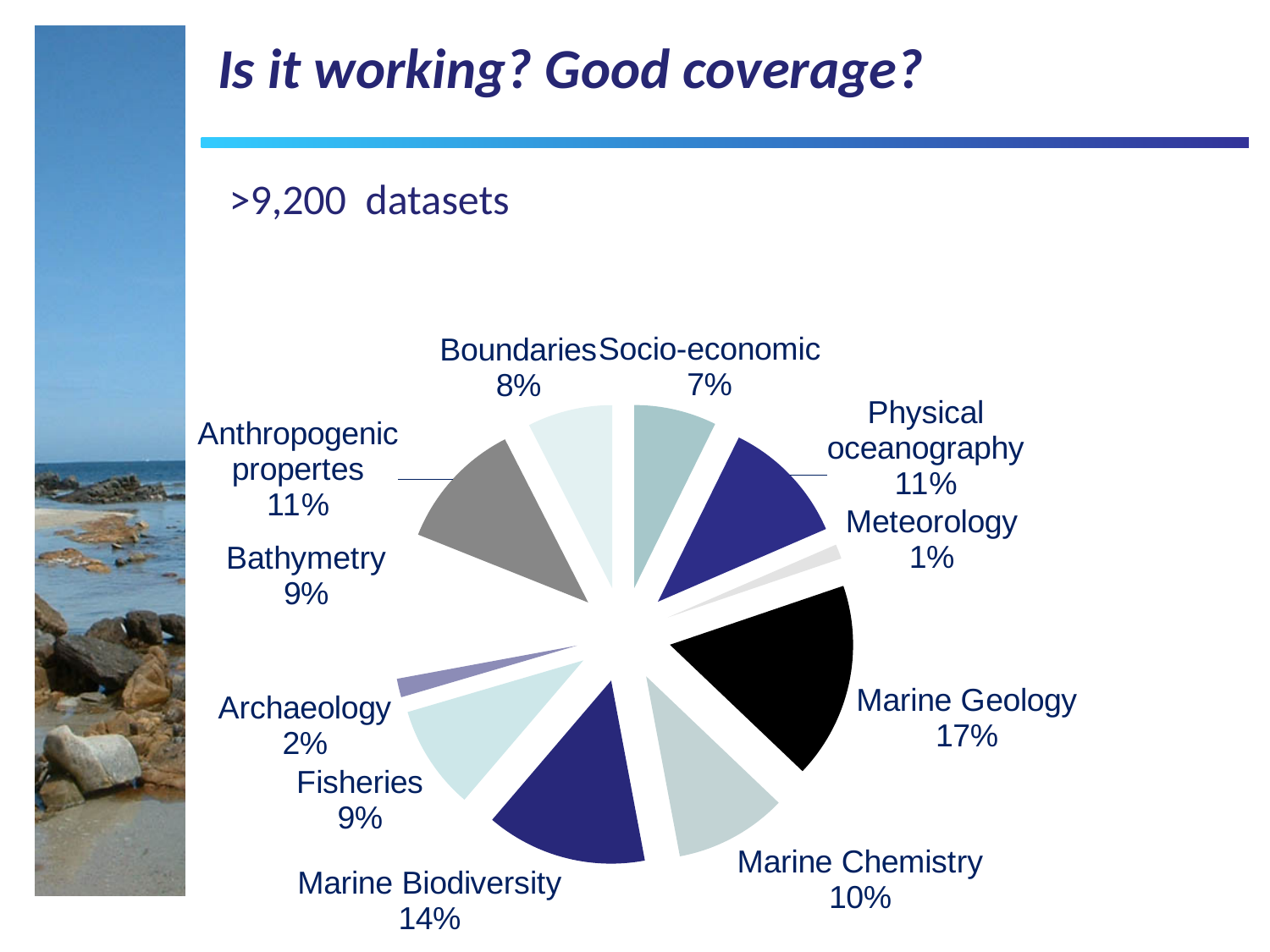
What colour is the Marine Geology slice? Black What percentage is shown for Marine Biodiversity? 14% How many categories are shown in the pie chart? 11 Which category has the largest slice of the pie? Marine Geology What percentage is shown for Boundaries? 8% Which is larger, the slice for Fisheries or the slice for Marine Biodiversity? Marine Biodiversity What is the difference in percentage points between Marine Geology and Marine Chemistry? 7 What is the difference in percentage points between Physical oceanography and Socio-economic? 4 What percentage is shown for Meteorology? 1% What kind of chart is shown on the slide? Pie chart What share of the pie does Marine Geology have? 17% Which category has the smallest slice of the pie? Meteorology